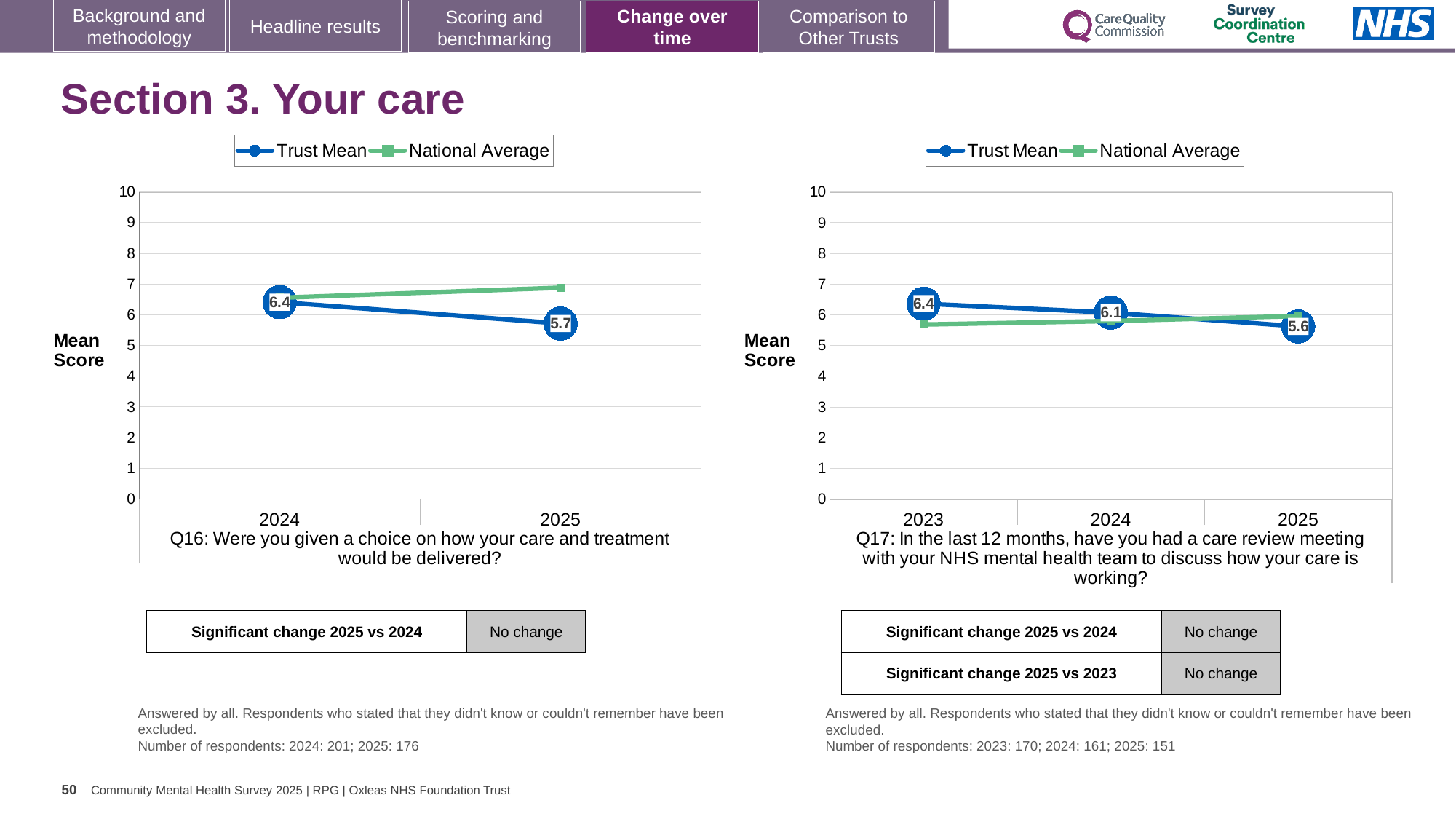
What type of chart is used for Q17 on the right? Line chart In the right chart (Q17), how many years are plotted on the x axis? 3 In the right chart (Q17), what is the Trust Mean for 2025? 5.6 In the left chart (Q16), by how much did the Trust Mean fall from 2024 to 2025? 0.7 In the left chart (Q16), is the National Average for 2025 greater or less than 6? greater In the right chart (Q17), what is the difference between the Trust Mean in 2023 and in 2025? 0.8 In the right chart (Q17), which year has the lowest Trust Mean? 2025 In the right chart (Q17), what is the Trust Mean for 2023? 6.4 In the left chart (Q16), what is the Trust Mean for 2024? 6.4 In the left chart (Q16), does the Trust Mean rise or fall from 2024 to 2025? fall In the left chart (Q16), what is the Trust Mean for 2025? 5.7 How many series does the legend of the left chart (Q16) list? 2